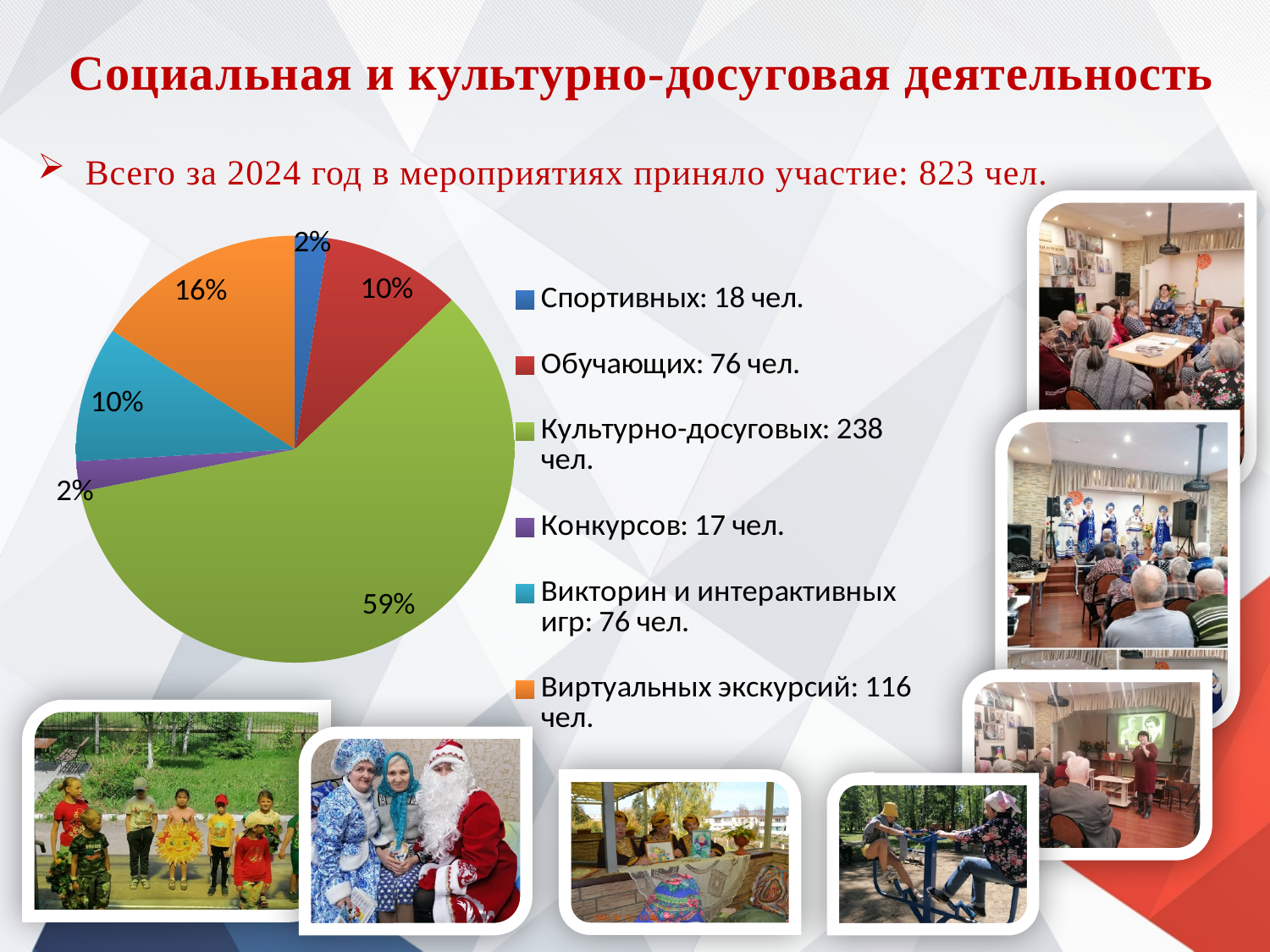
What share of the pie does Виртуальных экскурсий take? 16% How many categories does the pie chart have? 6 What is the total number of participants in events for 2024 stated on the slide? 823 чел. Which category has the smallest number of participants according to the legend? Конкурсов What colour is the slice for Культурно-досуговых? green What kind of chart is shown on the slide? pie chart What is the difference in participants between Культурно-досуговых (238) and Виртуальных экскурсий (116)? 122 How many people participated in Обучающих events according to the legend? 76 чел. What share of the pie does Культурно-досуговых take? 59% How many people participated in Спортивных events according to the legend? 18 чел. Which has more participants: Виртуальных экскурсий or Обучающих? Виртуальных экскурсий Which category has the largest share of the pie? Культурно-досуговых